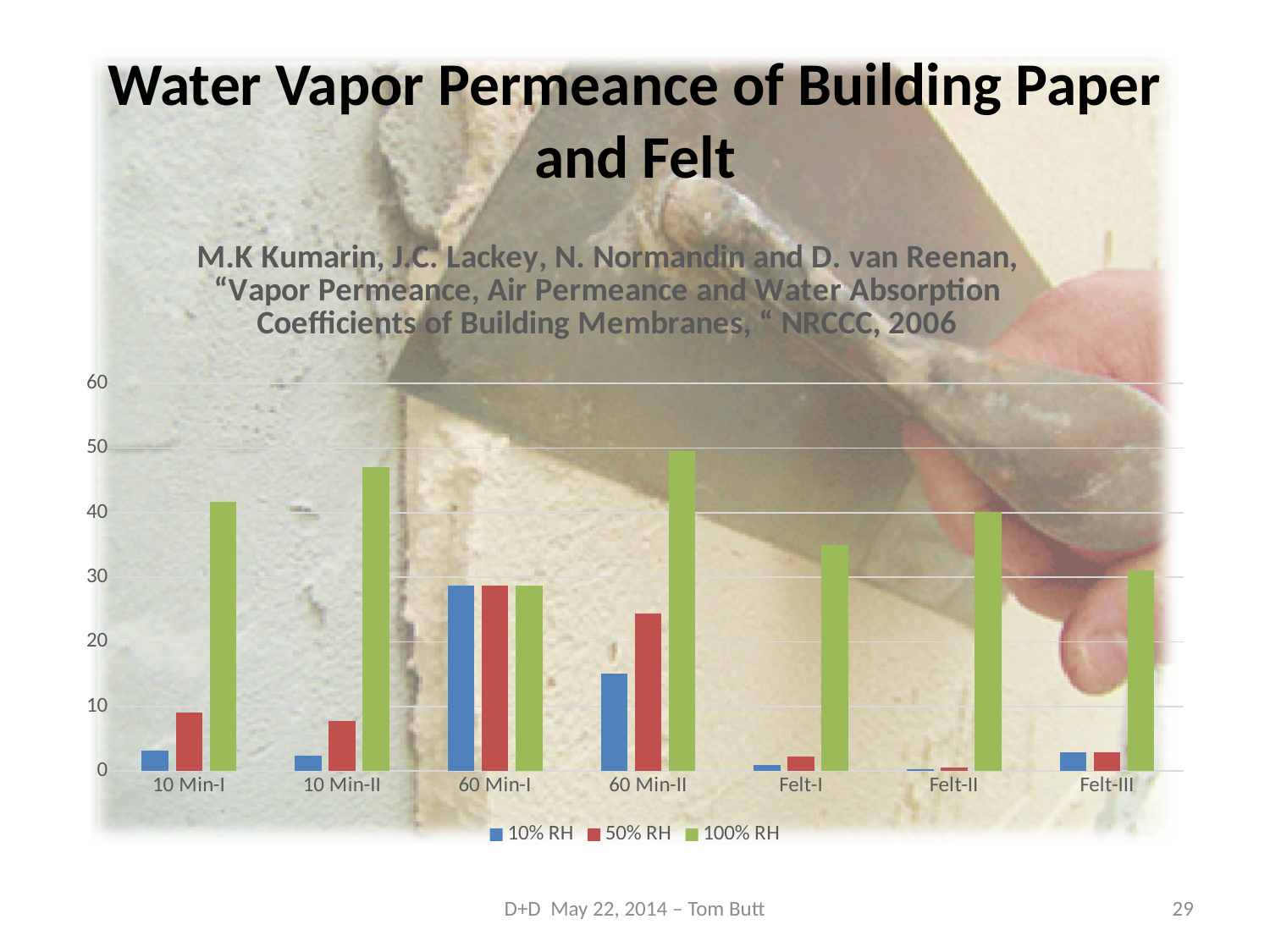
Which category has the lowest value for the 10% RH series? Felt-II Is the 50% RH value for 60 Min-II greater or less than 20? greater Which is larger, the 10% RH value for 60 Min-I or the 10% RH value for 60 Min-II? 60 Min-I Which category has the highest value for the 50% RH series? 60 Min-I Which is larger, the 100% RH value for 10 Min-II or the 100% RH value for 10 Min-I? 10 Min-II What are the three series named in the chart's legend? 10% RH, 50% RH, 100% RH How many categories are shown along the x axis of the chart? 7 How many series does the chart's legend list? 3 Which category has the highest value for the 10% RH series? 60 Min-I What kind of chart is shown on the slide? bar chart Is the 100% RH value for Felt-I greater or less than 40? less Is the 100% RH value for 60 Min-II greater or less than 40? greater